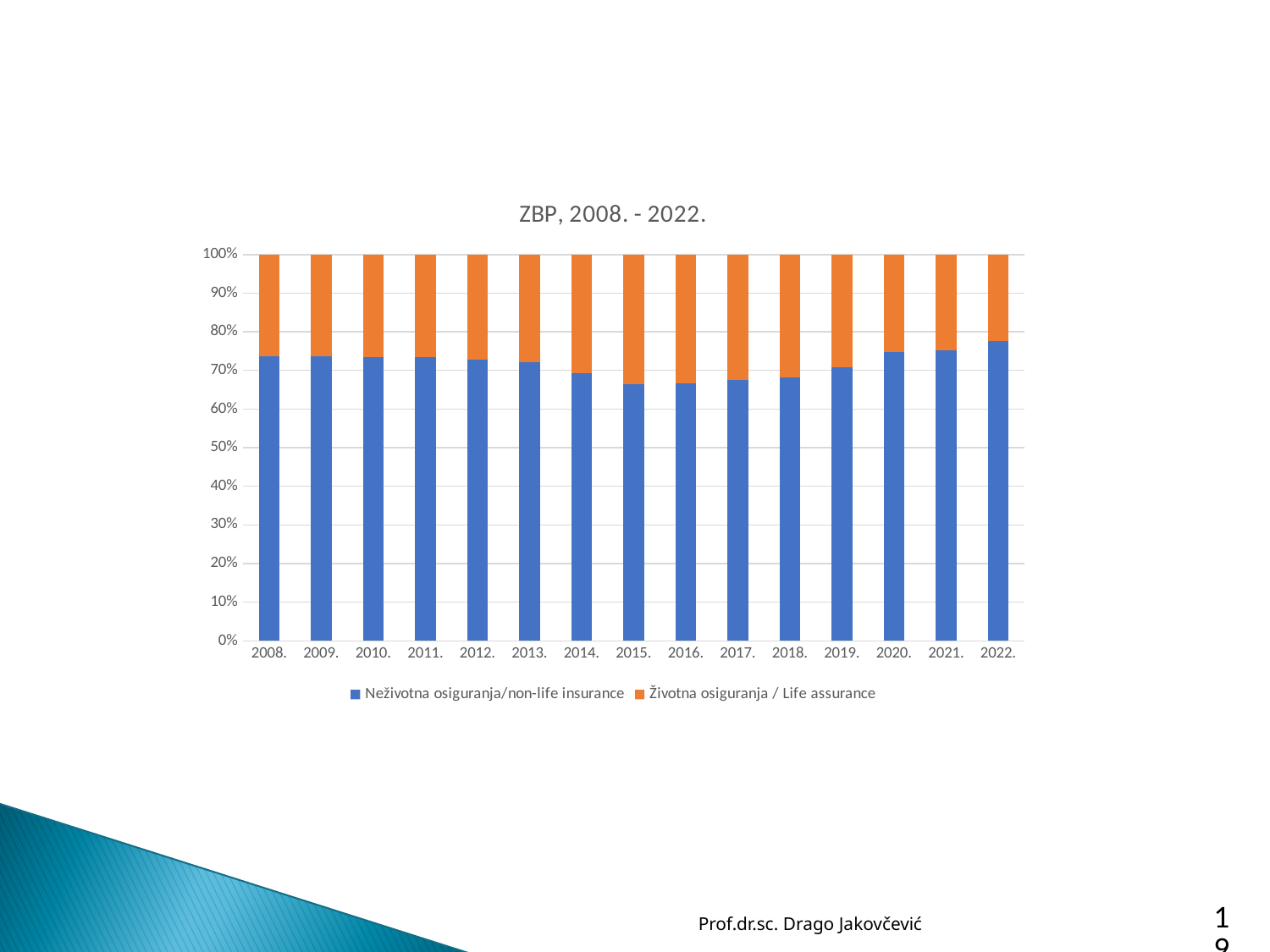
What is the total of the stacked bar for 2010? 100% Is the value for Neživotna osiguranja/non-life insurance in 2015 greater or less than 70%? less How many years are shown on the x axis of the chart? 15 Is the value for Neživotna osiguranja/non-life insurance in 2008 greater or less than 80%? less How many series does the legend list? 2 What is the title of the chart? ZBP, 2008. - 2022. In which year is the share of Neživotna osiguranja/non-life insurance the highest? 2022. Is the value for Neživotna osiguranja/non-life insurance in 2022 greater or less than 70%? greater Which series is shown in orange in the chart? Životna osiguranja / Life assurance What type of chart is shown on the slide? Stacked bar chart Which year has the larger share of Neživotna osiguranja/non-life insurance, 2008 or 2015? 2008. Does the share of Neživotna osiguranja/non-life insurance rise or fall from 2015 to 2022? rise